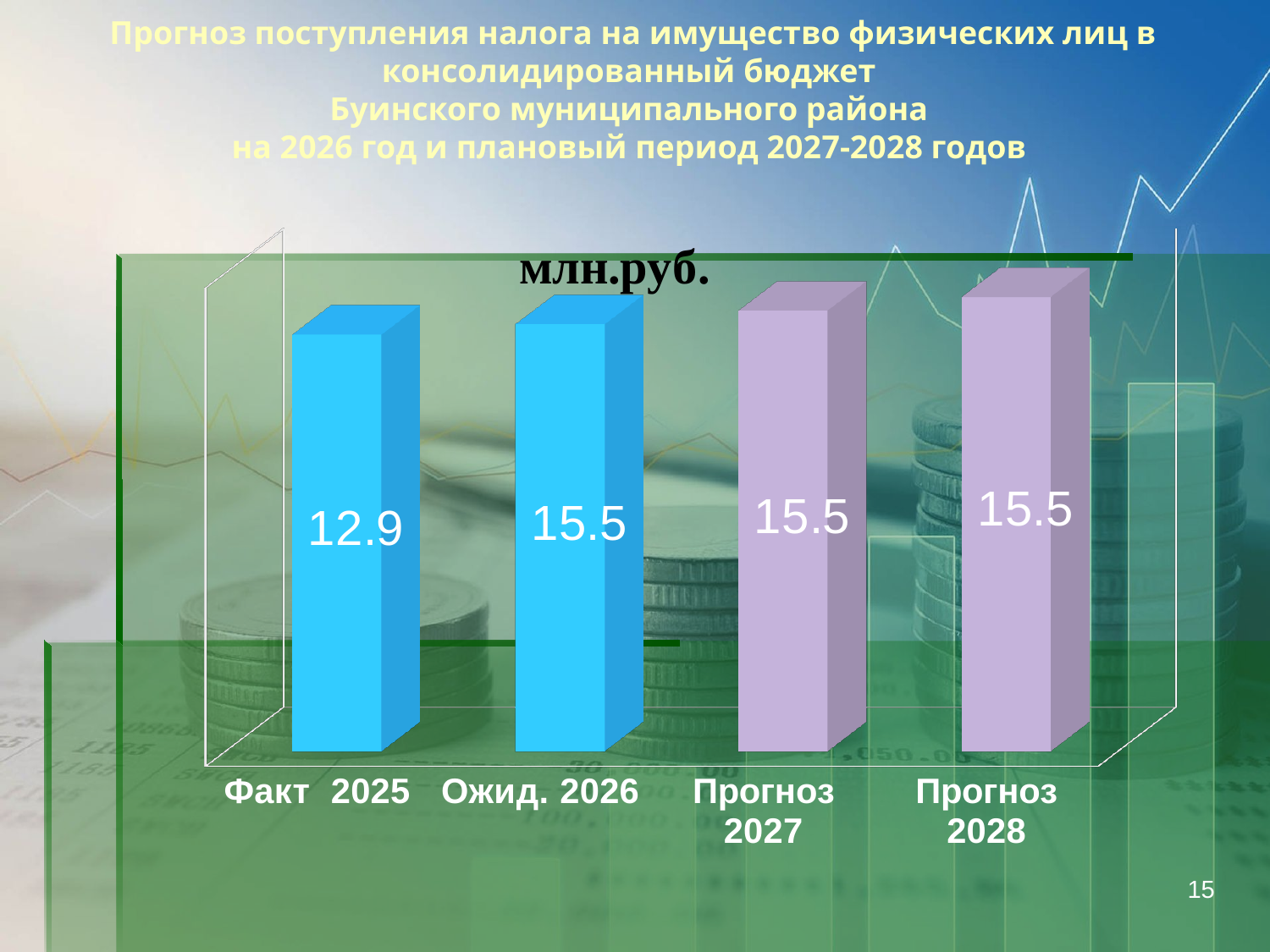
What is the value for Прогноз 2027? 15.5 Which is larger, the value for Факт 2025 or the value for Прогноз 2027? Прогноз 2027 What is the value for Ожид. 2026? 15.5 Which category has the lowest value? Факт 2025 What is the difference between the values for Ожид. 2026 and Факт 2025? 2.6 Does the value rise or fall from Факт 2025 to Ожид. 2026? Rise What unit is shown above the chart? млн.руб. How many categories are shown on the chart? 4 What colour are the bars for Прогноз 2027 and Прогноз 2028? Purple (lilac) What is the value for Факт 2025? 12.9 What kind of chart is shown on the slide? Bar chart What is the value for Прогноз 2028? 15.5